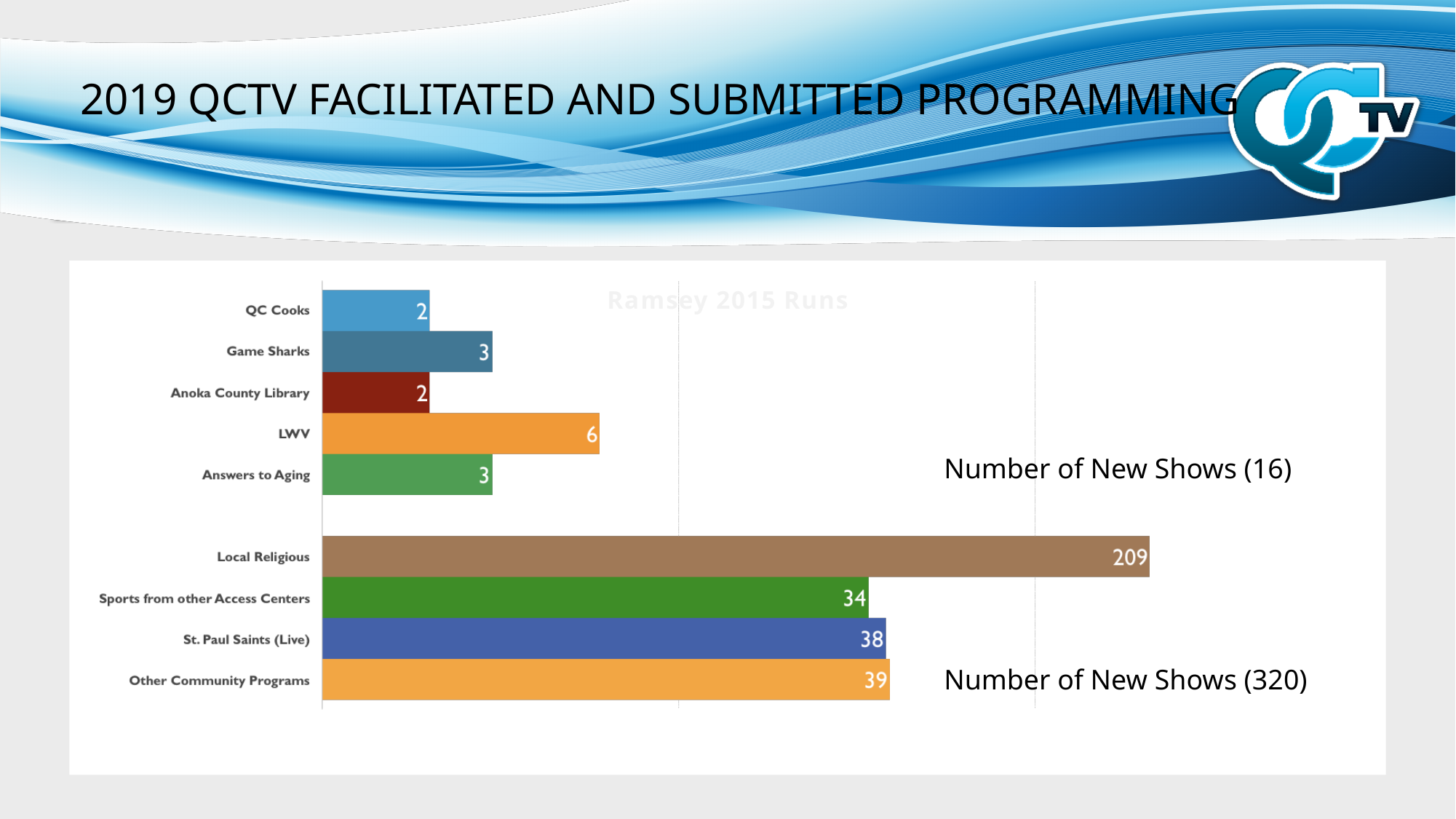
What is the difference between the values for Local Religious and Sports from other Access Centers? 175 What is the value for LWV? 6 What is the value for St. Paul Saints (Live)? 38 Which category has the highest value? Local Religious Which category has the highest value among the top group of five bars (QC Cooks through Answers to Aging)? LWV What is the difference between the values for Other Community Programs and St. Paul Saints (Live)? 1 What is the value for Local Religious? 209 What is the total number of new shows stated for the lower group of bars? 320 Which is larger, the value for Game Sharks or the value for LWV? LWV How many categories are shown in the chart? 9 What kind of chart is shown on the slide? Bar chart What is the value for Sports from other Access Centers? 34